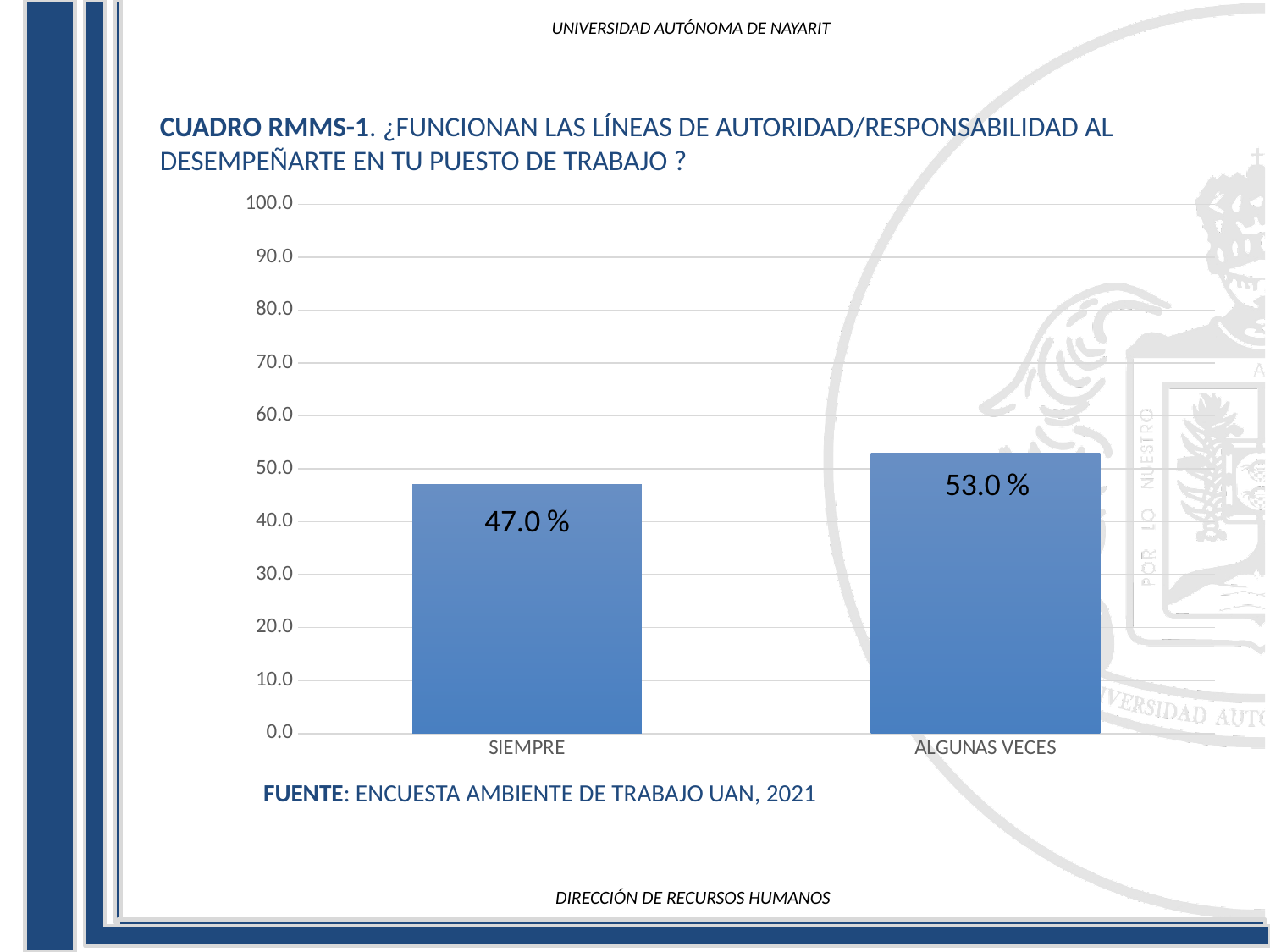
What is the maximum value shown on the y axis? 100.0 What kind of chart is shown on the slide? bar chart Which category has the highest value? ALGUNAS VECES How many categories are shown on the x axis? 2 Which category has the lowest value? SIEMPRE What is the value for SIEMPRE? 47.0 % What is the value for ALGUNAS VECES? 53.0 % What source is cited below the chart? ENCUESTA AMBIENTE DE TRABAJO UAN, 2021 Is the value for ALGUNAS VECES greater or less than 50.0? greater Is the value for SIEMPRE greater or less than 50.0? less What is the difference between the values for ALGUNAS VECES and SIEMPRE? 6.0 % Which is larger, the value for SIEMPRE or the value for ALGUNAS VECES? ALGUNAS VECES